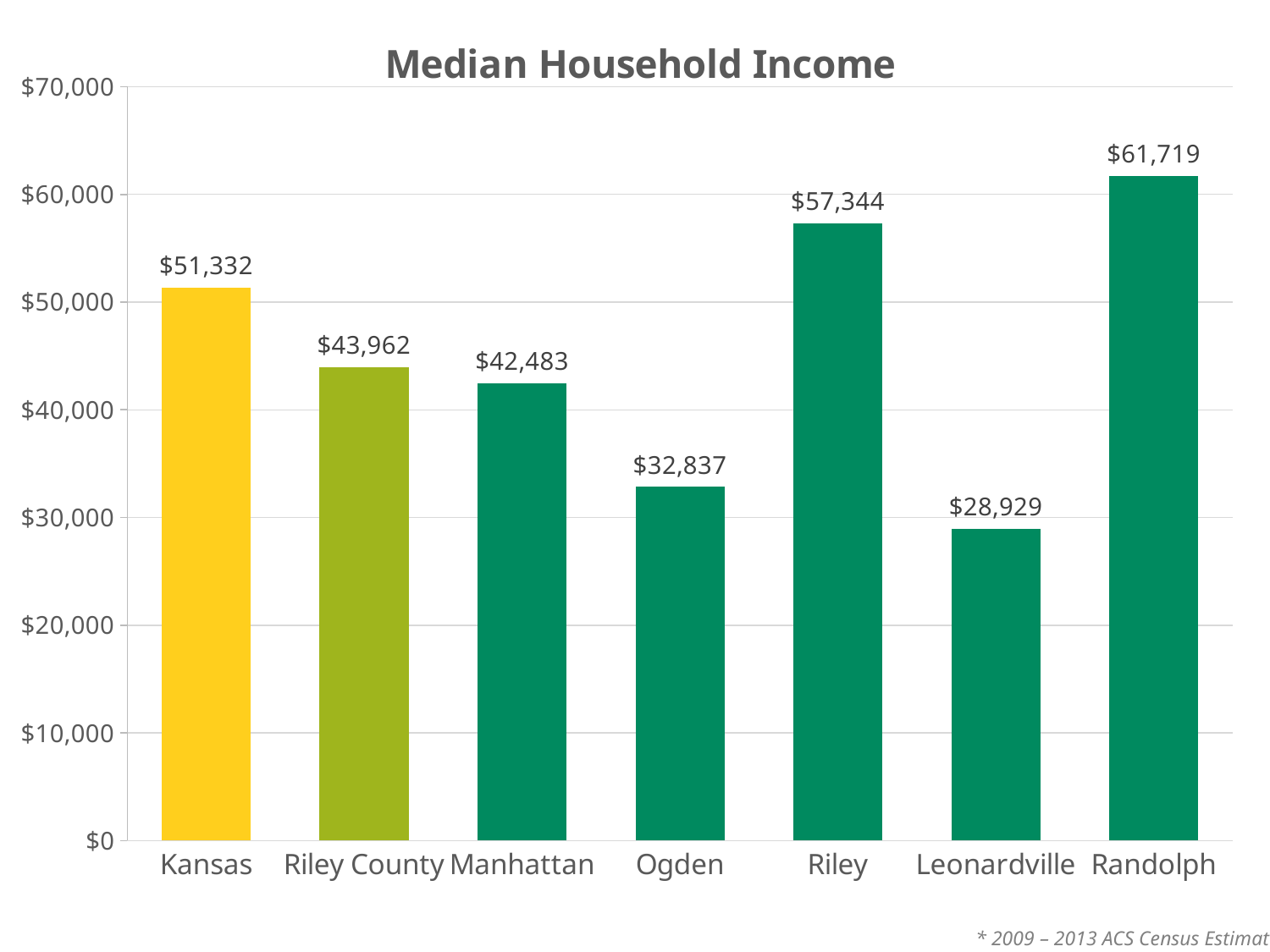
What is the median household income for Kansas? $51,332 Which category has the lowest median household income? Leonardville How many categories are shown in the chart? 7 What kind of chart is shown on the slide? Bar chart What is the title of the chart? Median Household Income What is the difference between the median household income of Kansas and Manhattan? $8,849 Which category has the highest median household income? Randolph What is the difference between the median household income of Randolph and Riley? $4,375 What is the median household income for Ogden? $32,837 Which has a higher median household income, Riley County or Manhattan? Riley County Is the value for Riley greater or less than $50,000? greater What is the median household income for Leonardville? $28,929